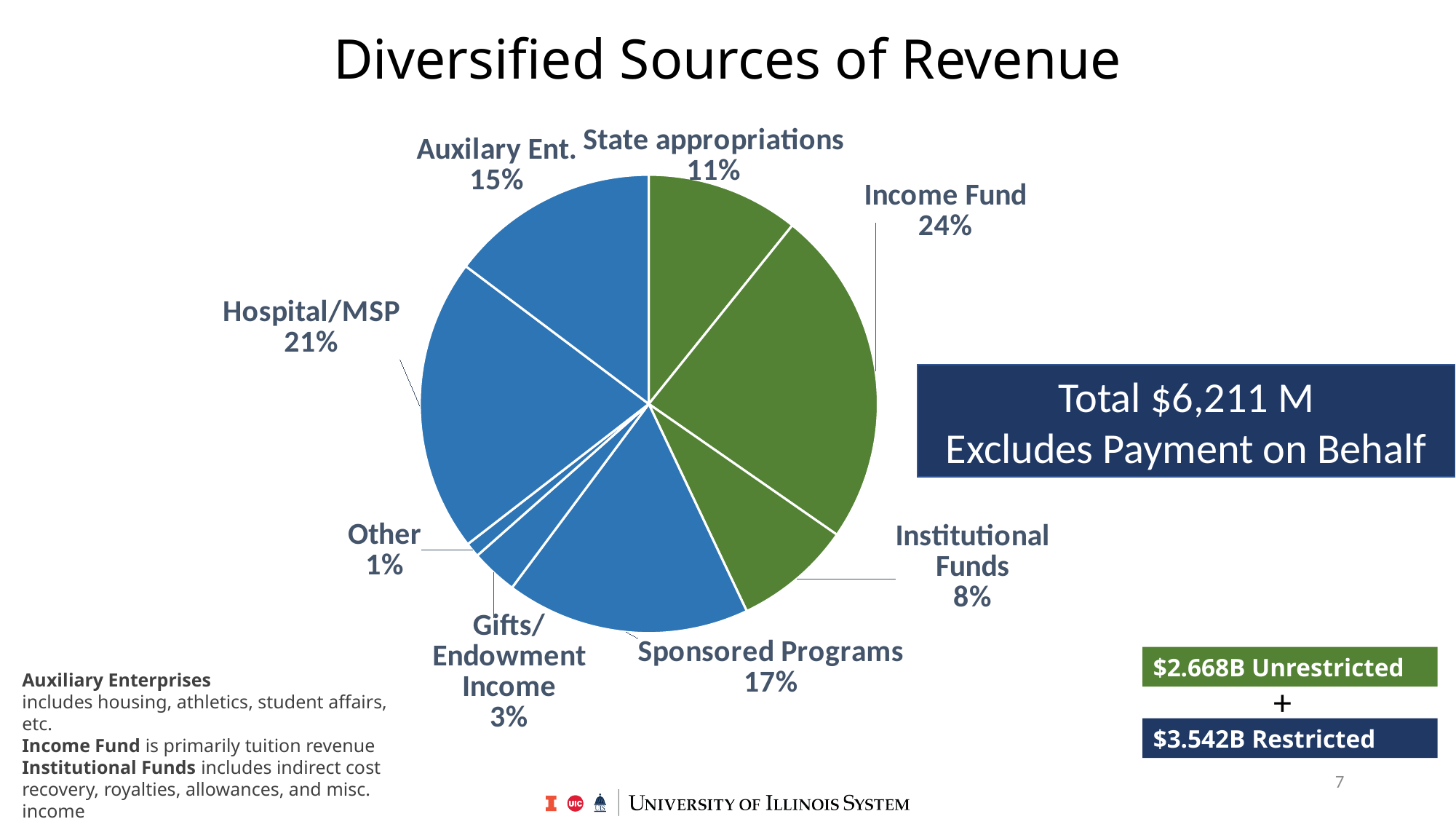
What kind of chart is shown on the slide? Pie chart How many revenue categories are shown in the pie chart? 8 What total revenue amount is stated next to the pie chart? $6,211 M What is the combined share of Gifts/Endowment Income and Other? 4% Which revenue source has the smallest share of the pie? Other What percentage of revenue comes from Hospital/MSP? 21% What share of revenue is Sponsored Programs? 17% What is the difference in percentage points between Income Fund and Institutional Funds? 16 What share of revenue does the Income Fund represent? 24% Which is larger, the share for Auxilary Ent. or the share for Sponsored Programs? Sponsored Programs Which revenue source has the largest share of the pie? Income Fund What percentage of revenue comes from State appropriations? 11%